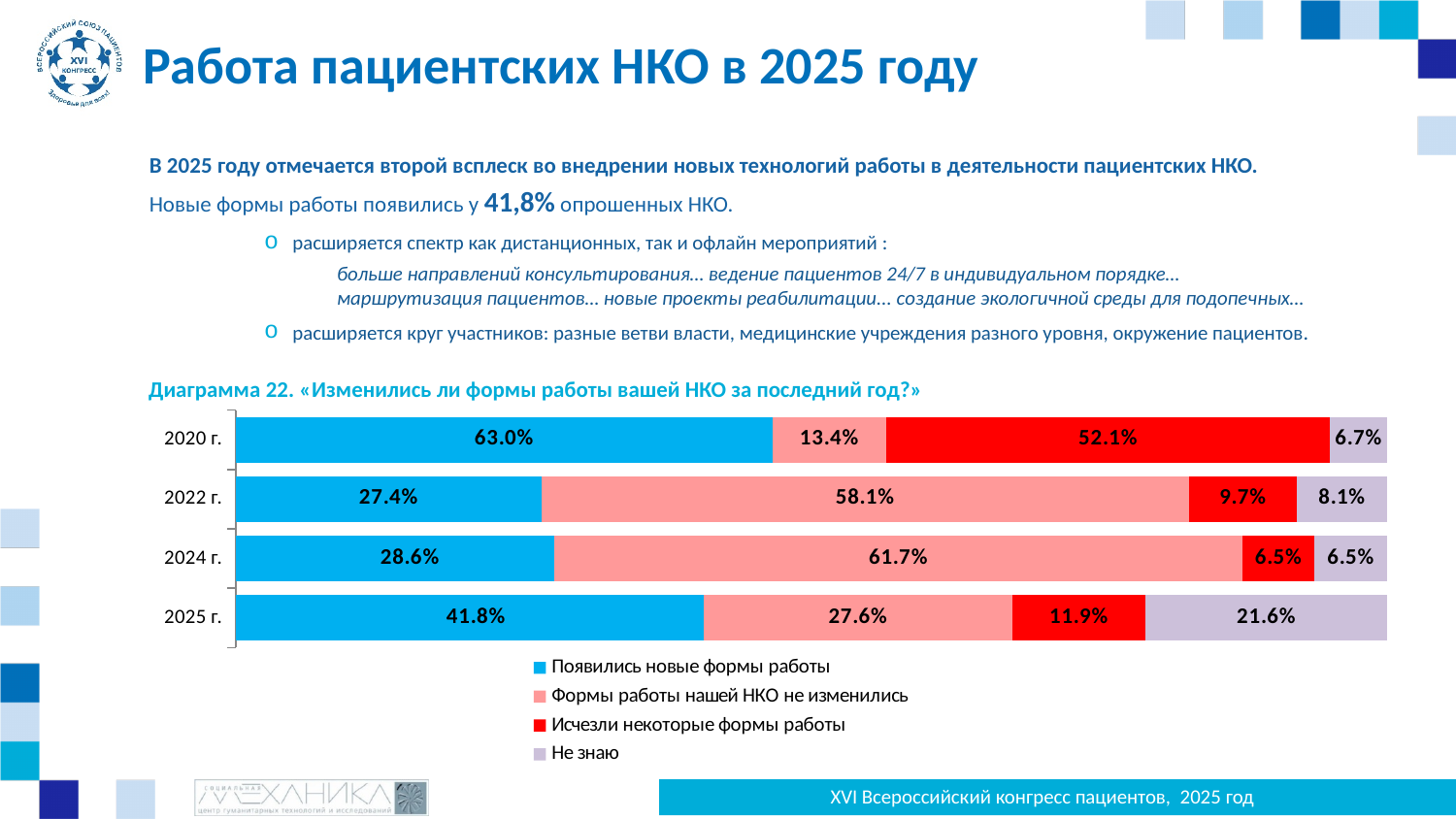
In which year is the value for «Исчезли некоторые формы работы» the lowest? 2024 г. What is the value for «Не знаю» in 2024 г.? 6.5% In which year is the value for «Появились новые формы работы» the highest? 2020 г. How many series does the legend list? 4 What is the title of the chart (Диаграмма 22)? «Изменились ли формы работы вашей НКО за последний год?» How many years (categories) are shown in the chart? 4 Which year has the larger value for «Не знаю»: 2022 г. or 2025 г.? 2025 г. What is the value for «Исчезли некоторые формы работы» in 2020 г.? 52.1% What kind of chart is shown on the slide? Stacked bar chart What is the difference between the «Появились новые формы работы» values for 2025 г. and 2024 г.? 13.2 percentage points What is the value for «Формы работы нашей НКО не изменились» in 2022 г.? 58.1% What is the value for «Появились новые формы работы» in 2025 г.? 41.8%